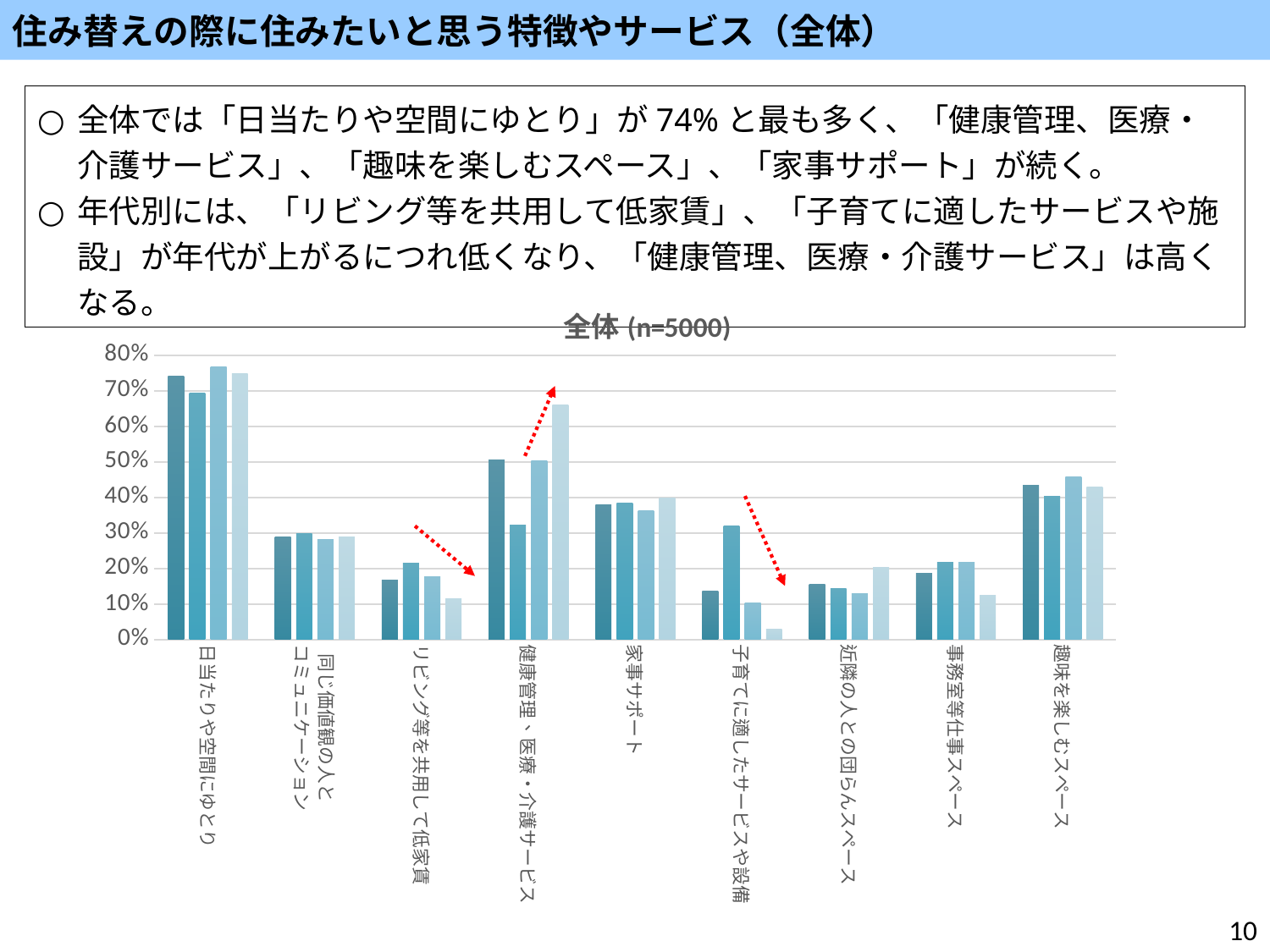
How many red dotted arrows are drawn on the chart? 3 Is the value of the first bar for 日当たりや空間にゆとり greater or less than 70%? greater Is the value of the fourth (lightest) bar for 子育てに適したサービスや設備 greater or less than 10%? less Which category contains the lowest bar in the chart? 子育てに適したサービスや設備 Which category has the highest bars in the chart? 日当たりや空間にゆとり Is the value of the fourth (lightest) bar for 健康管理・医療・介護サービス greater or less than 60%? greater How many categories are shown along the x axis of the chart? 9 Which is larger: the first bar for 健康管理・医療・介護サービス or the first bar for 家事サポート? 健康管理・医療・介護サービス What kind of chart is shown on the slide? bar chart How many bars are plotted for each category in the chart? 4 What is the title of the chart? 全体 (n=5000)